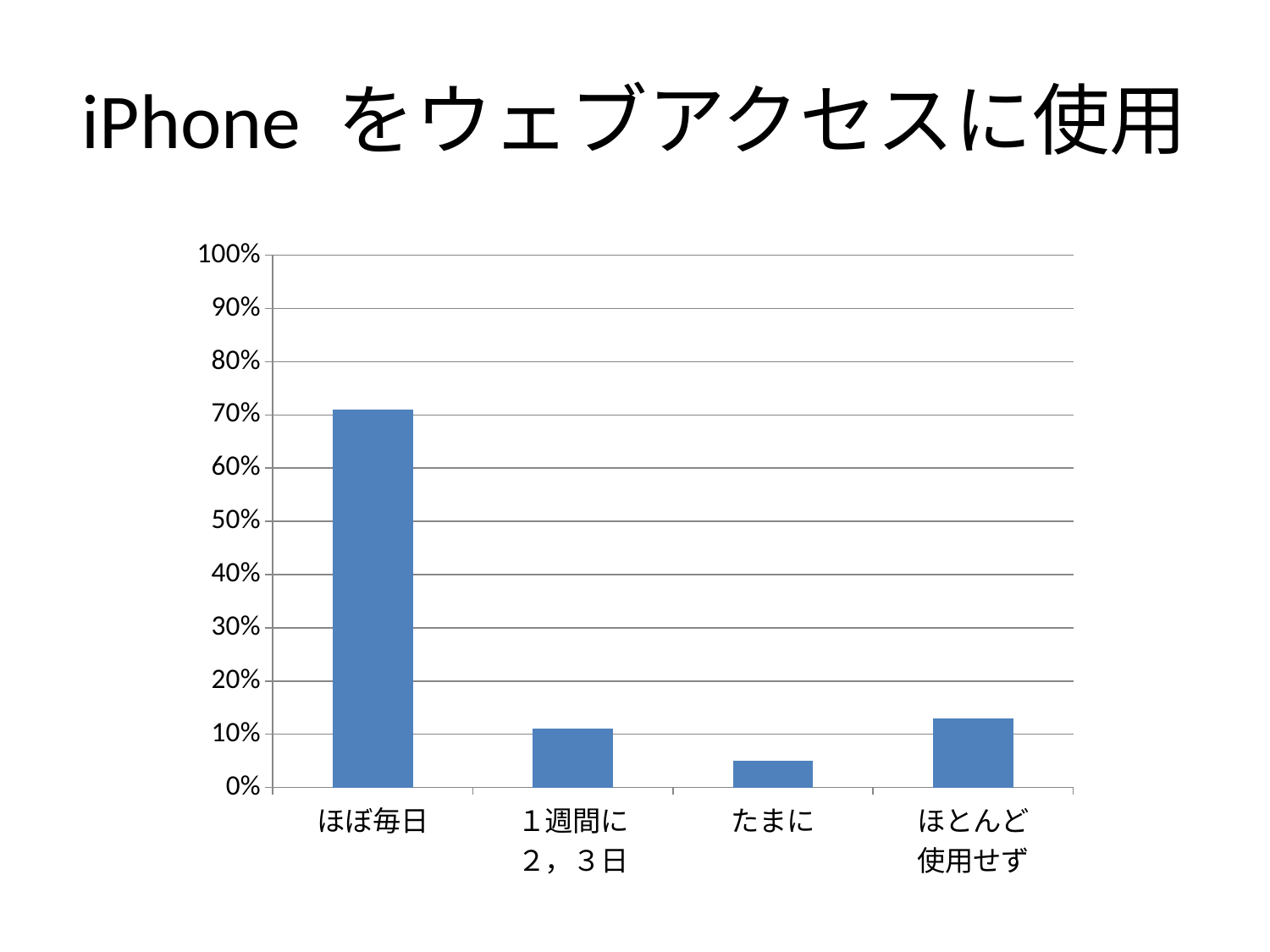
What kind of chart is shown on the slide? bar chart Is the value for ほぼ毎日 greater or less than 80%? less Which category has the highest value in the chart? ほぼ毎日 What is the title of the slide containing the chart? iPhone をウェブアクセスに使用 Is the value for １週間に２，３日 greater or less than 20%? less Is the value for ほとんど使用せず greater or less than 20%? less Which category has the lowest value in the chart? たまに How many categories are shown on the x axis of the chart? 4 Which is larger, the value for １週間に２，３日 or the value for たまに? １週間に２，３日 Which is larger, the value for ほぼ毎日 or the value for ほとんど使用せず? ほぼ毎日